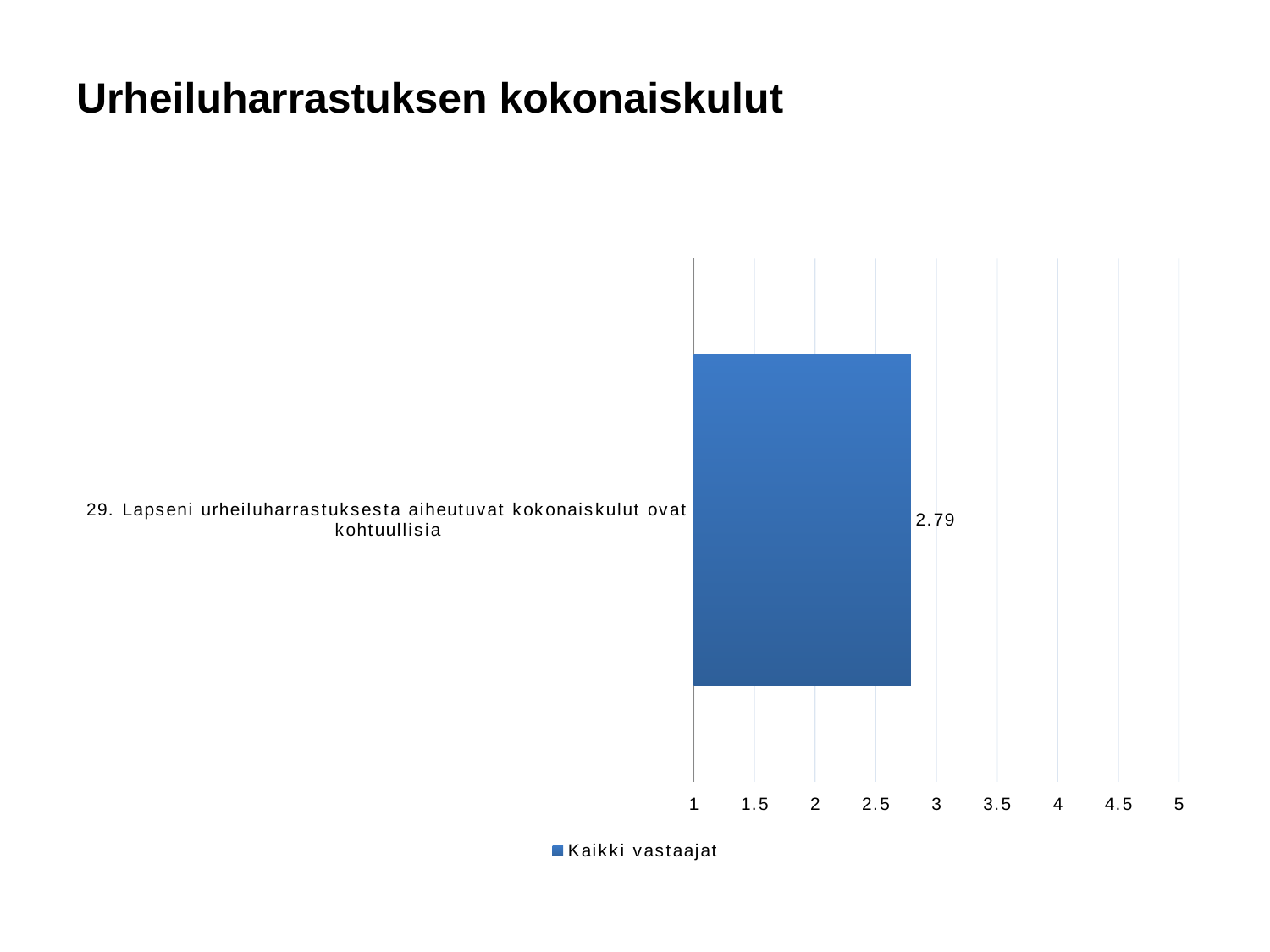
What is the value for "29. Lapseni urheiluharrastuksesta aiheutuvat kokonaiskulut ovat kohtuullisia"? 2.79 What series name is shown in the legend? Kaikki vastaajat What is the title of the slide? Urheiluharrastuksen kokonaiskulut Is the value for "29. Lapseni urheiluharrastuksesta aiheutuvat kokonaiskulut ovat kohtuullisia" greater or less than 3? less How many categories are plotted in the chart? 1 What is the lowest value shown on the x axis? 1 Is the value for "29. Lapseni urheiluharrastuksesta aiheutuvat kokonaiskulut ovat kohtuullisia" greater or less than 2.5? greater What kind of chart is shown on the slide? bar chart What is the highest value shown on the x axis? 5 How many series does the legend list? 1